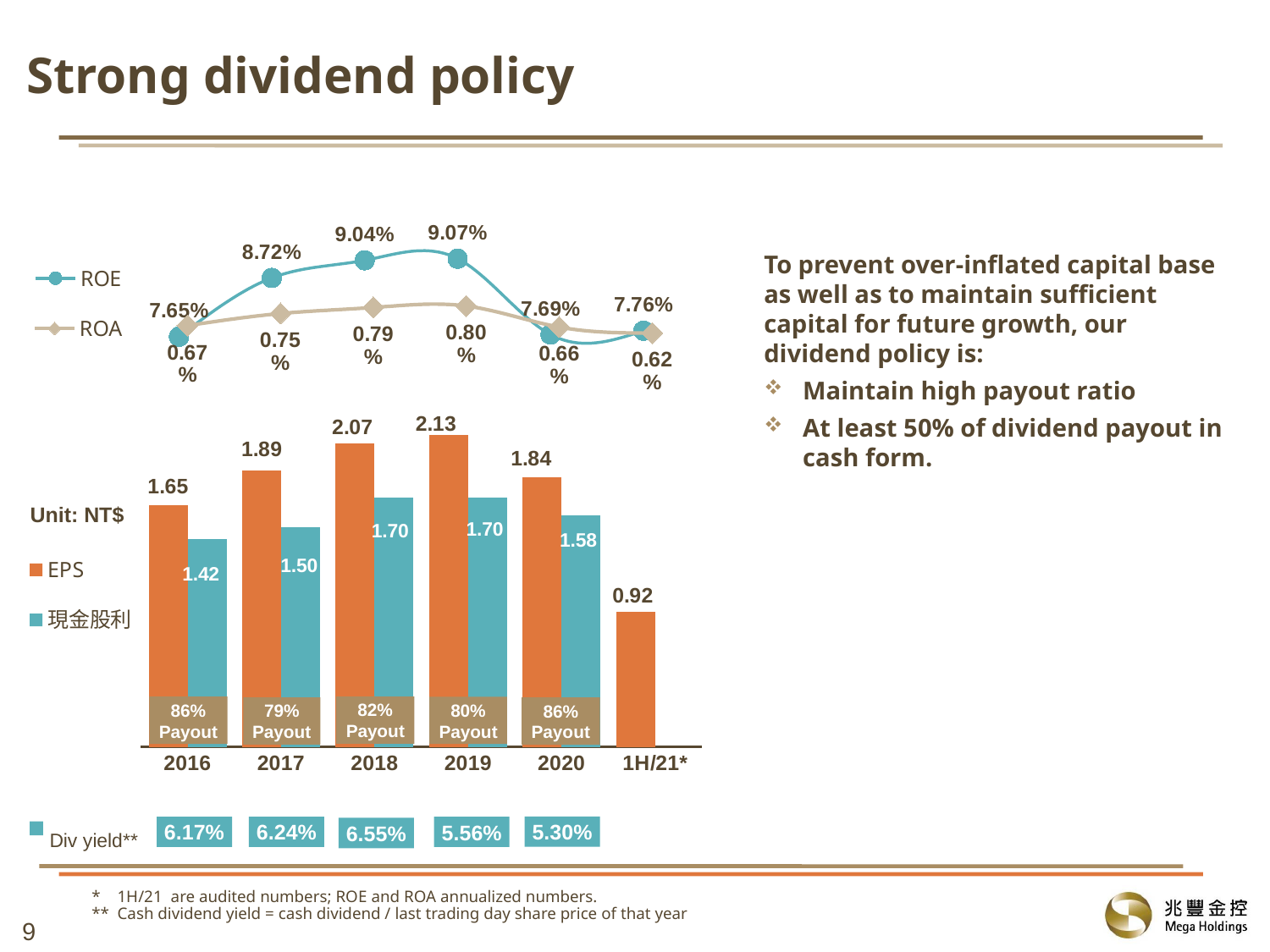
In the top line chart, what is the ROE value for 2018? 9.04% In the top line chart, does ROE rise or fall from 2016 to 2019? rise In the top line chart, which year has the highest ROE? 2019 In the bottom bar chart, which is larger: the cash dividend in 2017 or in 2016? 2017 In the bottom bar chart, what is the EPS for 2019? 2.13 In the top line chart, what is the difference between the ROE in 2019 and the ROE in 2016? 1.42 percentage points In the bottom bar chart, which year has the highest EPS? 2019 In the bottom bar chart, what is the difference between EPS and cash dividend in 2018? 0.37 In the top line chart, which period has the lowest ROA? 1H/21 What kind of chart is the bottom chart showing EPS and cash dividend? bar chart In the bottom bar chart, what is the cash dividend (現金股利) for 2020? 1.58 How many series does the legend of the bottom bar chart list? 2